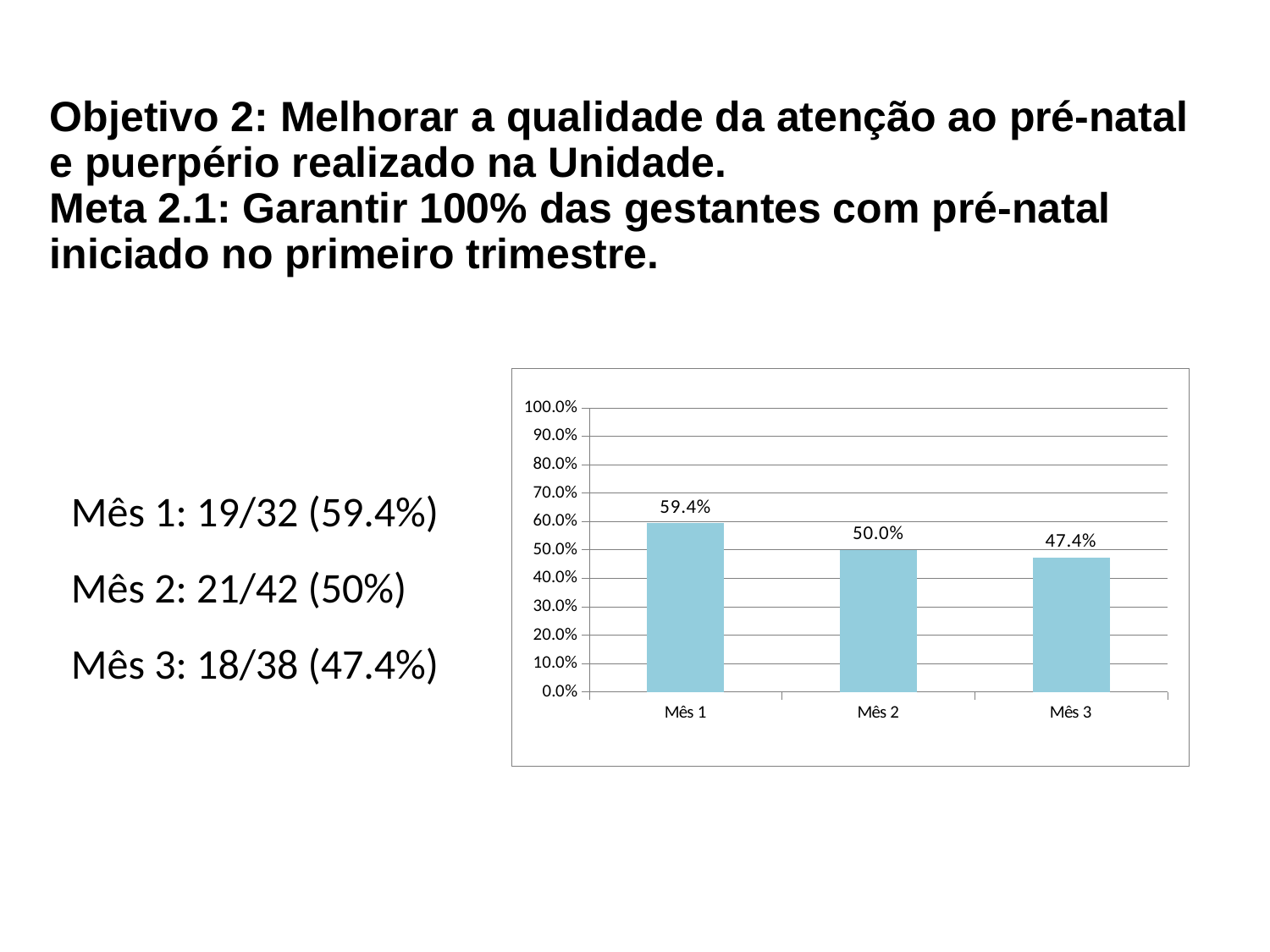
How many categories are shown on the x axis? 3 Do the values rise or fall from Mês 1 to Mês 3? fall What is the difference between the values for Mês 1 and Mês 3? 12.0% Is the value for Mês 1 greater or less than 50.0%? greater What is the value for Mês 3? 47.4% Which is larger, the value for Mês 2 or the value for Mês 3? Mês 2 What kind of chart is shown on the slide? bar chart What is the value for Mês 1? 59.4% Which category has the highest value? Mês 1 What is the difference between the values for Mês 1 and Mês 2? 9.4% What is the value for Mês 2? 50.0% Which category has the lowest value? Mês 3